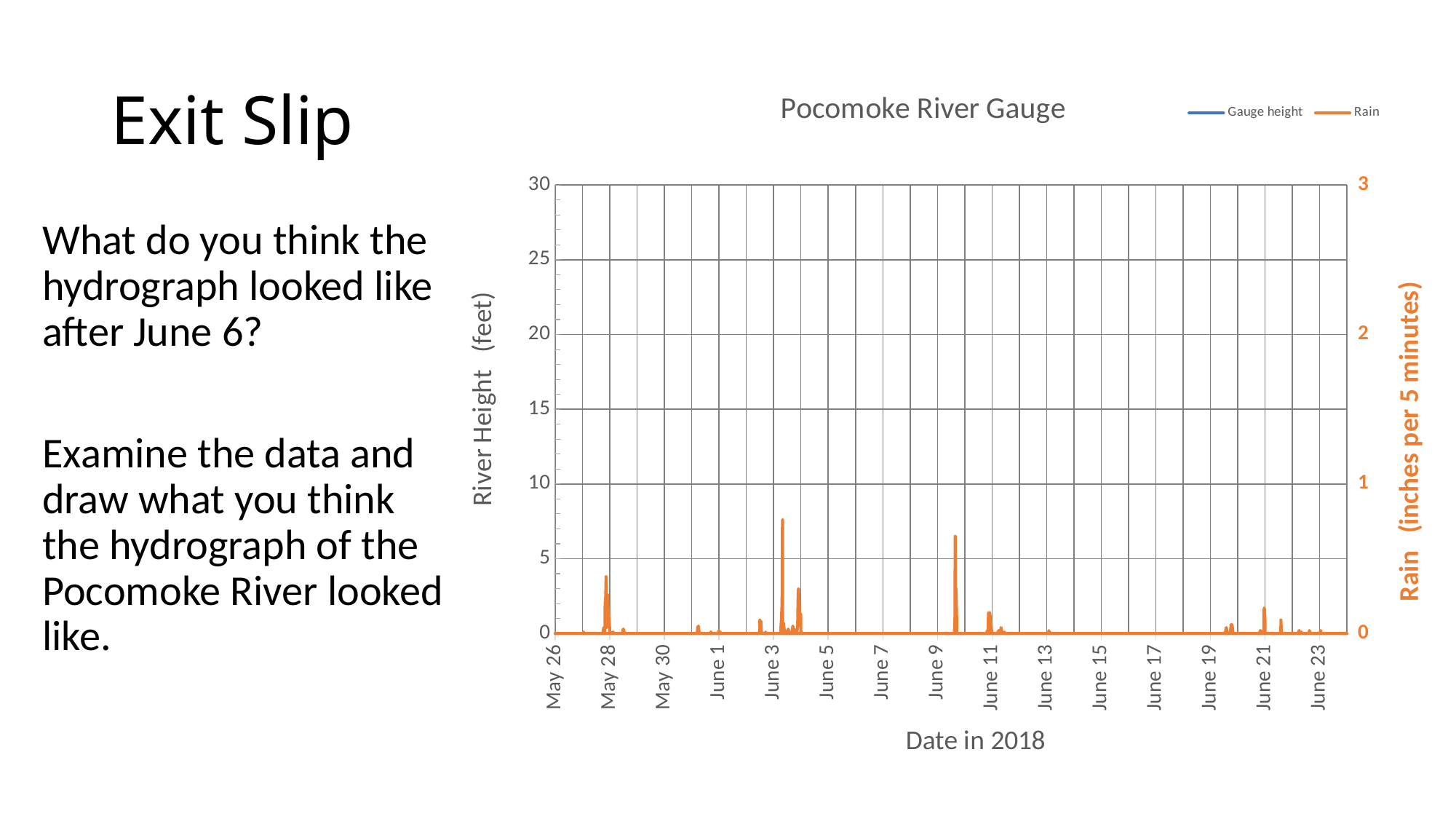
Is the rain spike near June 10 greater or less than 1 inch per 5 minutes on the right-hand axis? less What is the title of the chart? Pocomoke River Gauge Is the rain spike near May 28 greater or less than 1 inch per 5 minutes on the right-hand axis? less What is the highest value shown on the right-hand Rain axis? 3 How many date labels are shown along the x axis? 15 Around which date does the tallest rain spike occur? just after June 3 Which rain spike is taller: the one just after June 3 or the one near May 28? the one just after June 3 Which rain spike is taller: the one just after June 3 or the one near June 10? the one just after June 3 Is the largest rain spike (just after June 3) greater or less than 1 inch per 5 minutes on the right-hand axis? less How many series does the legend of the Pocomoke River Gauge chart list? 2 Which series is drawn in orange according to the legend? Rain What kind of chart is shown on the slide? line chart